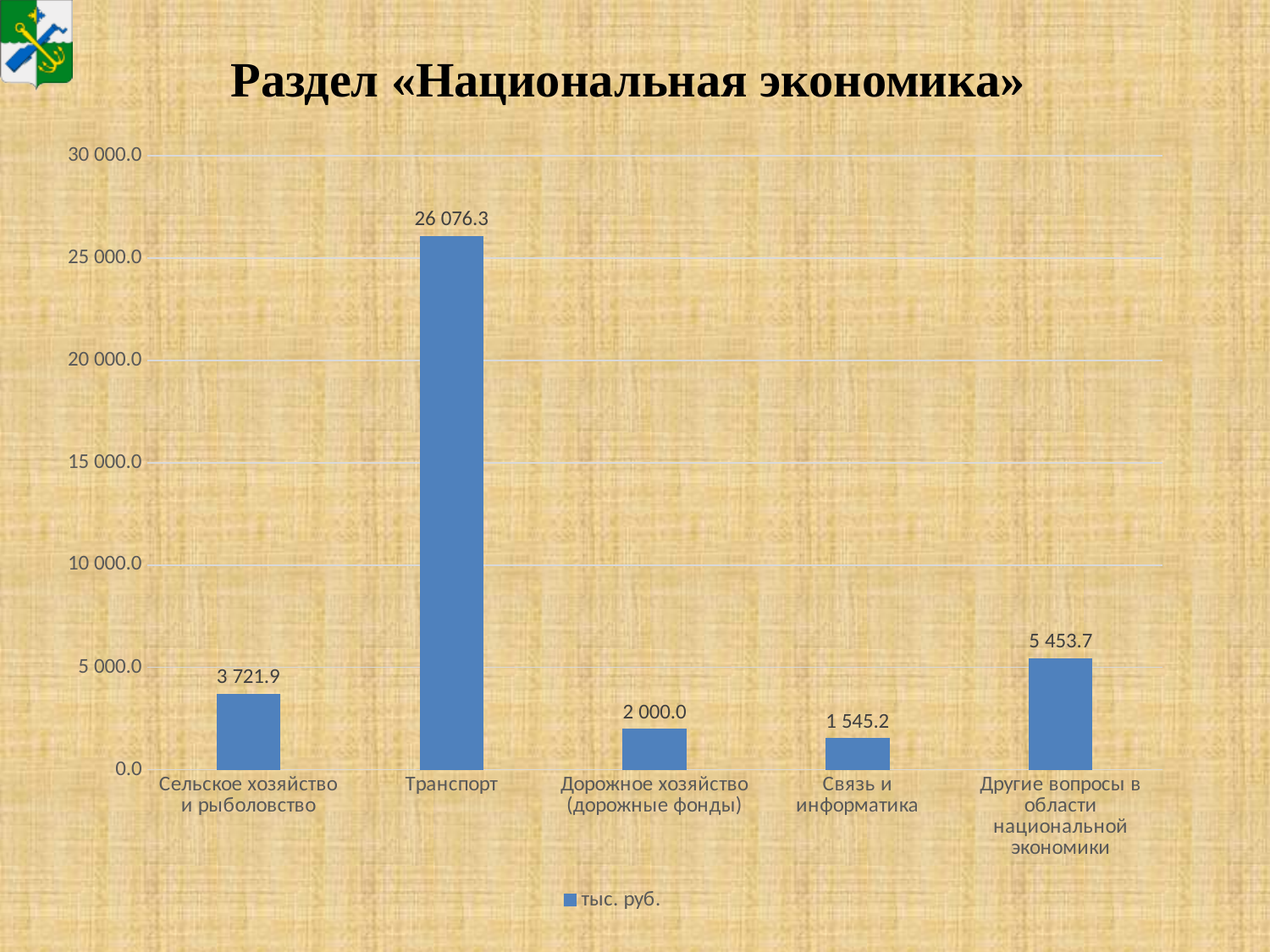
What is the value for Сельское хозяйство и рыболовство? 3 721.9 What is the legend entry shown below the chart? тыс. руб. Which category has the highest value? Транспорт What kind of chart is shown on the slide? Bar chart What is the value for Транспорт? 26 076.3 Which is larger, the value for Другие вопросы в области национальной экономики or the value for Сельское хозяйство и рыболовство? Другие вопросы в области национальной экономики What is the difference between the values for Дорожное хозяйство (дорожные фонды) and Связь и информатика? 454.8 What is the difference between the values for Транспорт and Сельское хозяйство и рыболовство? 22 354.4 How many categories are shown on the chart? 5 Which category has the lowest value? Связь и информатика What is the value for Связь и информатика? 1 545.2 What is the value for Другие вопросы в области национальной экономики? 5 453.7